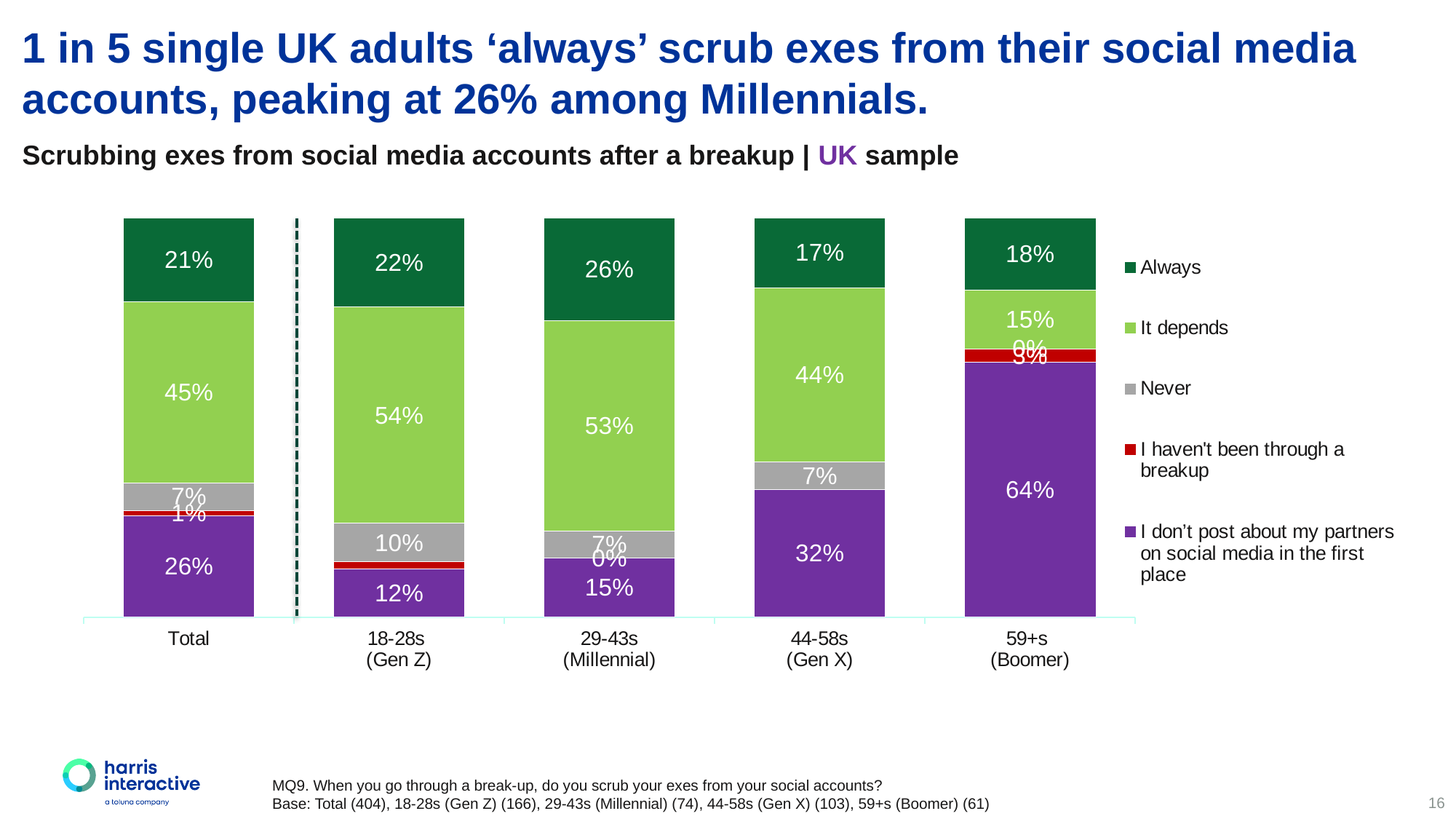
Which group has a larger 'Never' value, 18-28s (Gen Z) or 29-43s (Millennial)? 18-28s (Gen Z) What percentage of 29-43s (Millennial) say they 'Always' scrub exes from their social media accounts? 26% What percentage of 44-58s (Gen X) say they don't post about their partners on social media in the first place? 32% What is the 'Never' value for the Total bar? 7% How many bars (categories) are shown on the chart? 5 What type of chart is shown on the slide? Stacked bar chart How many percentage points higher is the 'Always' value for 29-43s (Millennial) than for 44-58s (Gen X)? 9 percentage points What is the 'It depends' value for the 18-28s (Gen Z) group? 54% What percentage of 59+s (Boomer) say they don't post about their partners on social media in the first place? 64% Which age group has the lowest 'Always' percentage? 44-58s (Gen X) How many series does the legend list? 5 Which age group has the highest 'Always' percentage? 29-43s (Millennial)